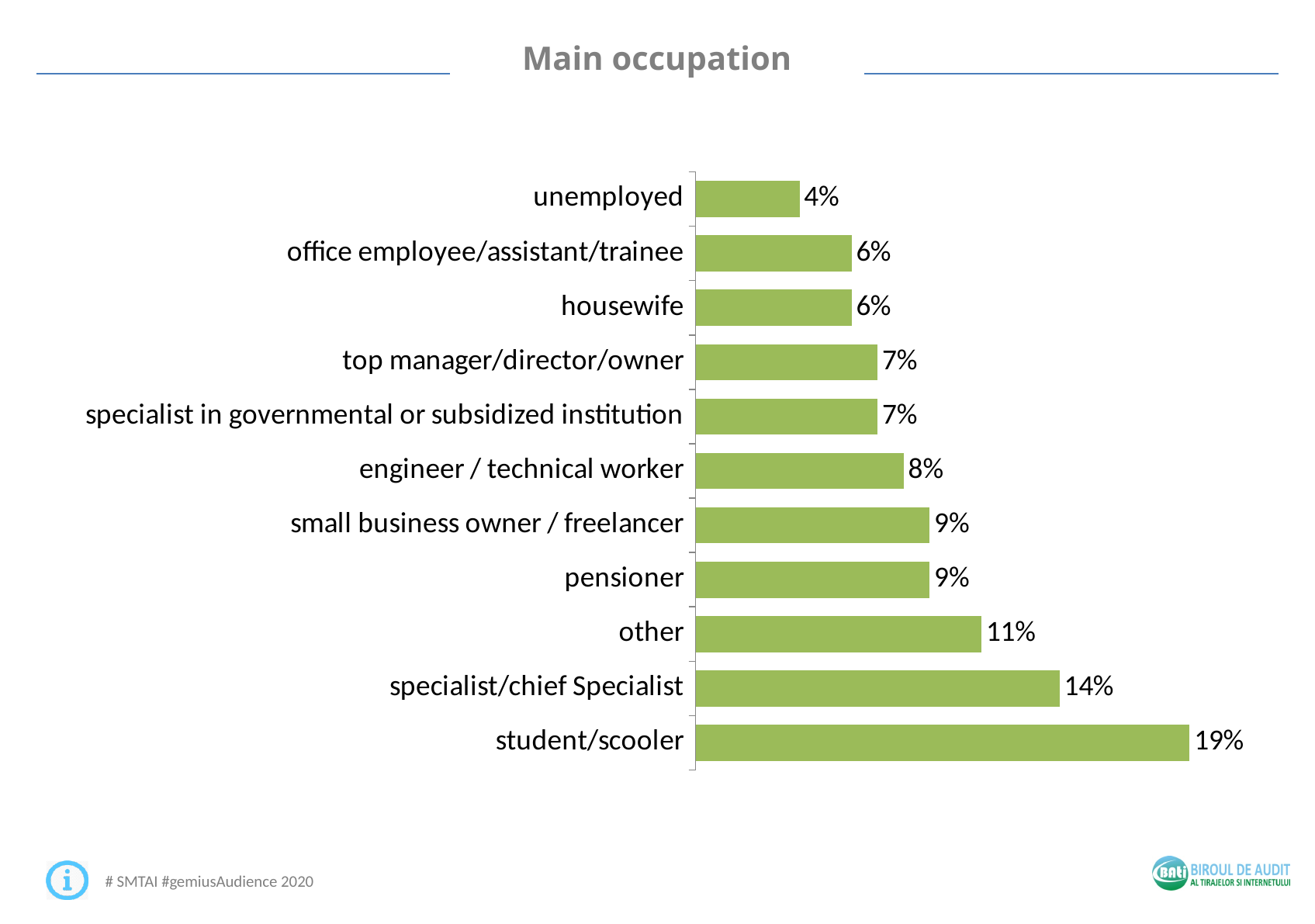
What is the value for student/scooler? 19% What is the value for engineer / technical worker? 8% What is the value for specialist/chief Specialist? 14% Which occupation category has the highest value? student/scooler How many occupation categories are shown in the chart? 11 What kind of chart is shown on the slide? bar chart What is the title of the chart? Main occupation Which occupation category has the lowest value? unemployed What is the difference between the values for other and unemployed? 7% What is the difference between the values for student/scooler and specialist/chief Specialist? 5% Which is larger, the value for pensioner or the value for top manager/director/owner? pensioner What is the value for unemployed? 4%